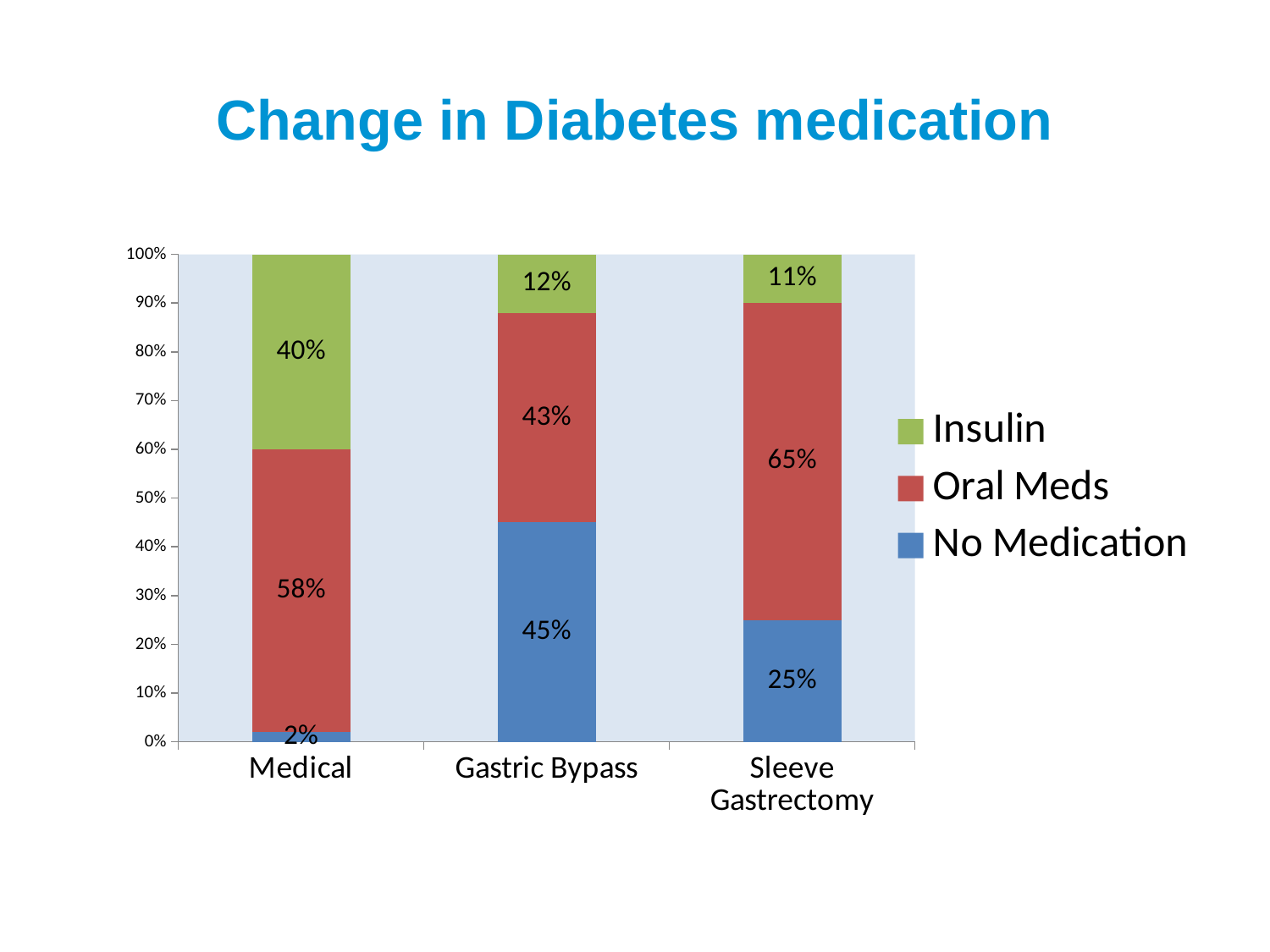
What percentage of the Medical group is on Insulin? 40% How many series does the legend list? 3 How many categories are shown on the x axis? 3 Which is larger: the Oral Meds share for Medical or for Gastric Bypass? Medical What is the title of the slide? Change in Diabetes medication What percentage of the Gastric Bypass group is on No Medication? 45% What percentage of the Sleeve Gastrectomy group is on Oral Meds? 65% What is the difference between the No Medication share for Gastric Bypass and for Sleeve Gastrectomy? 20% What percentage of the Medical group is on No Medication? 2% Which group has the lowest share on No Medication? Medical What kind of chart is shown on the slide? Stacked bar chart Which group has the highest share on Insulin? Medical